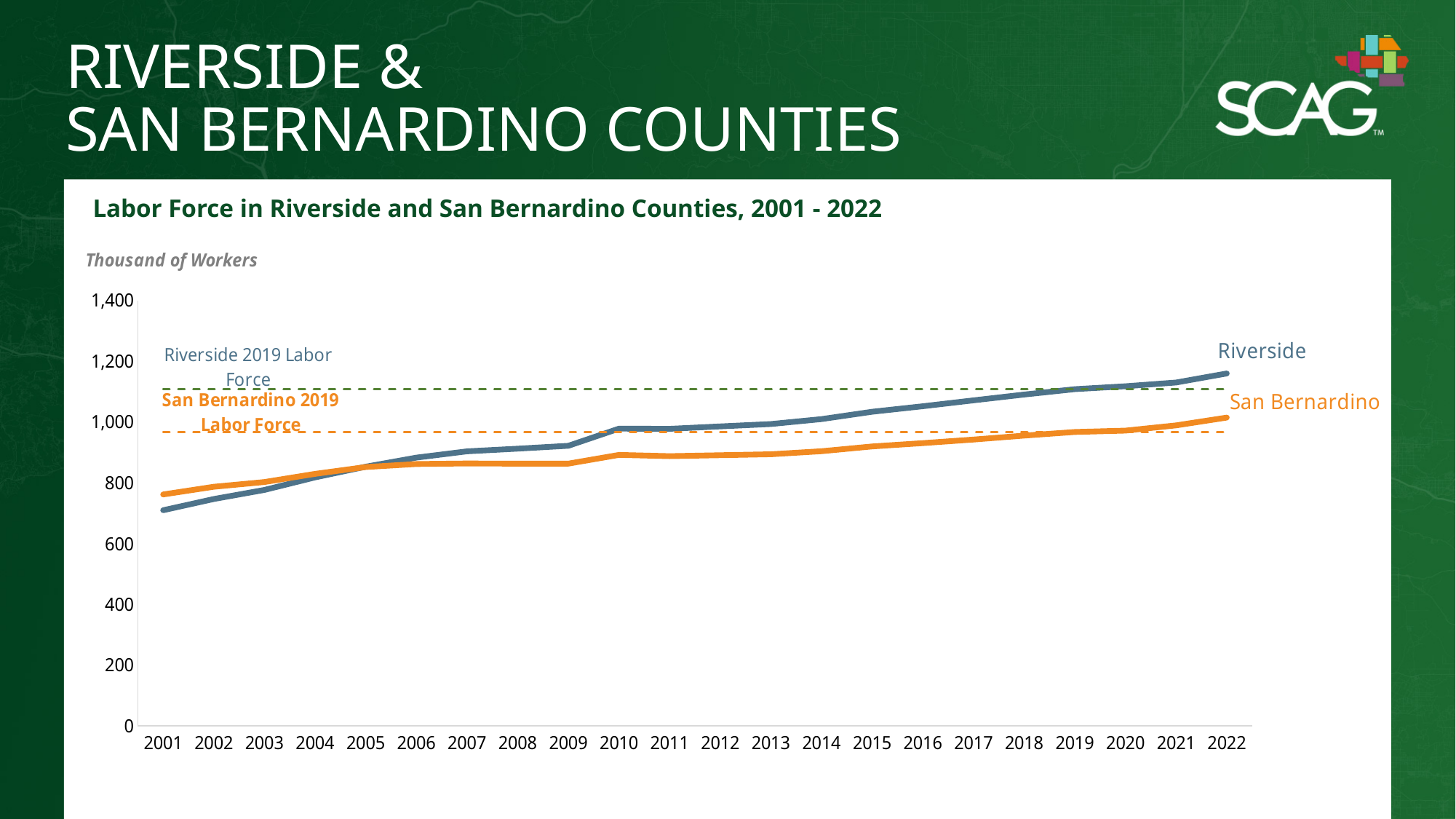
Is the Riverside value for 2022 greater or less than 1,000? greater What kind of chart is shown on the slide? Line chart Is the San Bernardino value for 2010 greater or less than 1,000? less How many county labor force series are plotted as solid lines on the chart? 2 Is the Riverside value for 2001 greater or less than 800? less How many years are shown along the x axis of the chart? 22 In what units are the values on the chart expressed? Thousand of Workers In 2022, which county has the larger labor force, Riverside or San Bernardino? Riverside In which year is the Riverside labor force at its lowest? 2001 Does the Riverside labor force generally rise or fall from 2001 to 2022? Rise What is the title of the chart? Labor Force in Riverside and San Bernardino Counties, 2001 - 2022 In 2001, which county has the larger labor force, Riverside or San Bernardino? San Bernardino